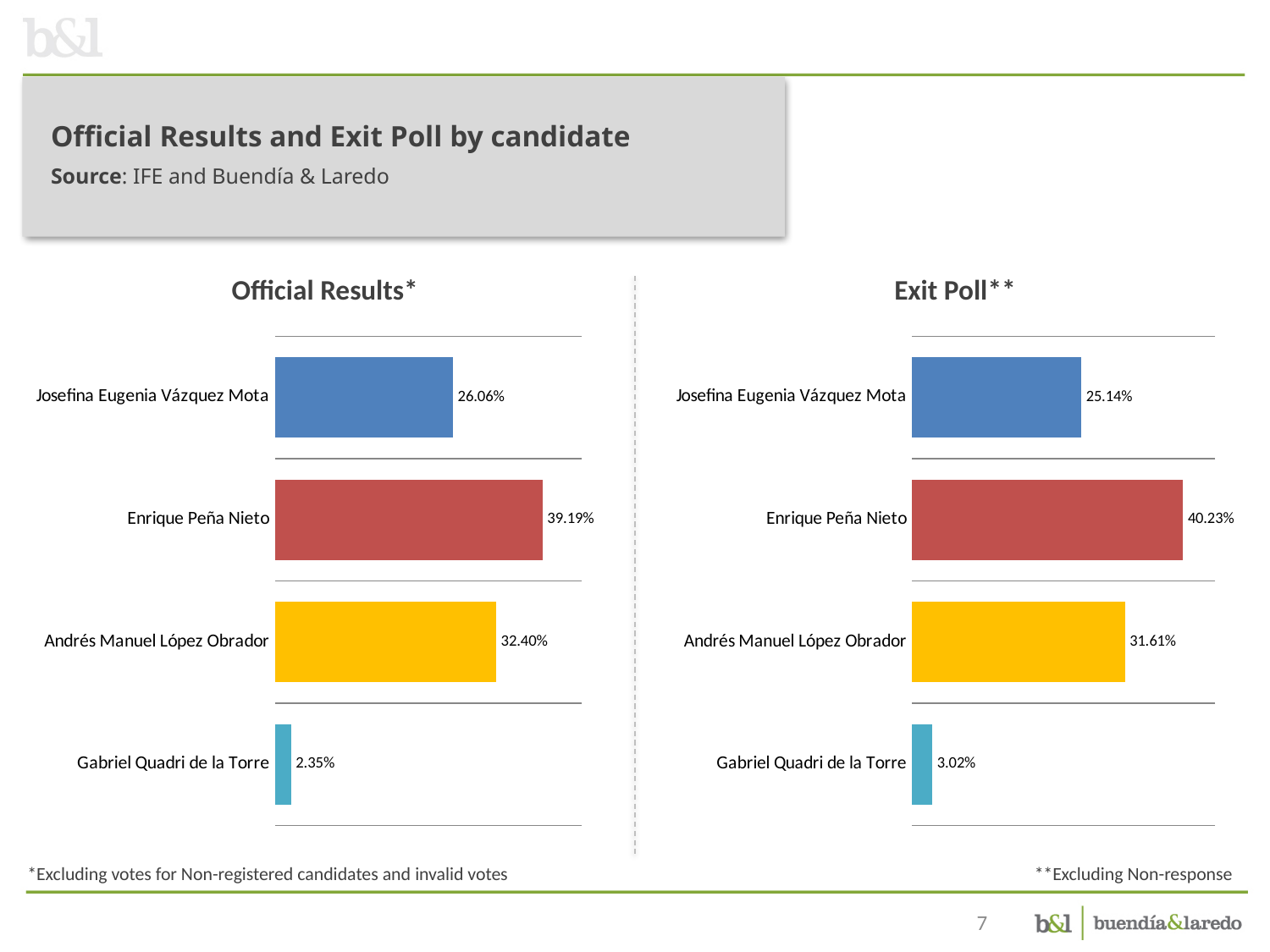
In the Exit Poll chart, what is the value for Josefina Eugenia Vázquez Mota? 25.14% What is the title of the chart on the right side of the slide? Exit Poll** In the Official Results chart, what is the value for Enrique Peña Nieto? 39.19% In the Official Results chart, what is the value for Andrés Manuel López Obrador? 32.40% In the Official Results chart, which candidate has the highest value? Enrique Peña Nieto How many candidates are shown in the Official Results chart? 4 In the Exit Poll chart, what is the value for Gabriel Quadri de la Torre? 3.02% In the Exit Poll chart, which candidate has the lowest value? Gabriel Quadri de la Torre Is Gabriel Quadri de la Torre's value higher in the Official Results chart or the Exit Poll chart? Exit Poll What type of chart is the Exit Poll chart? Bar chart In the Exit Poll chart, what is the difference between Andrés Manuel López Obrador and Josefina Eugenia Vázquez Mota? 6.47% In the Official Results chart, what is the difference between Enrique Peña Nieto and Andrés Manuel López Obrador? 6.79%